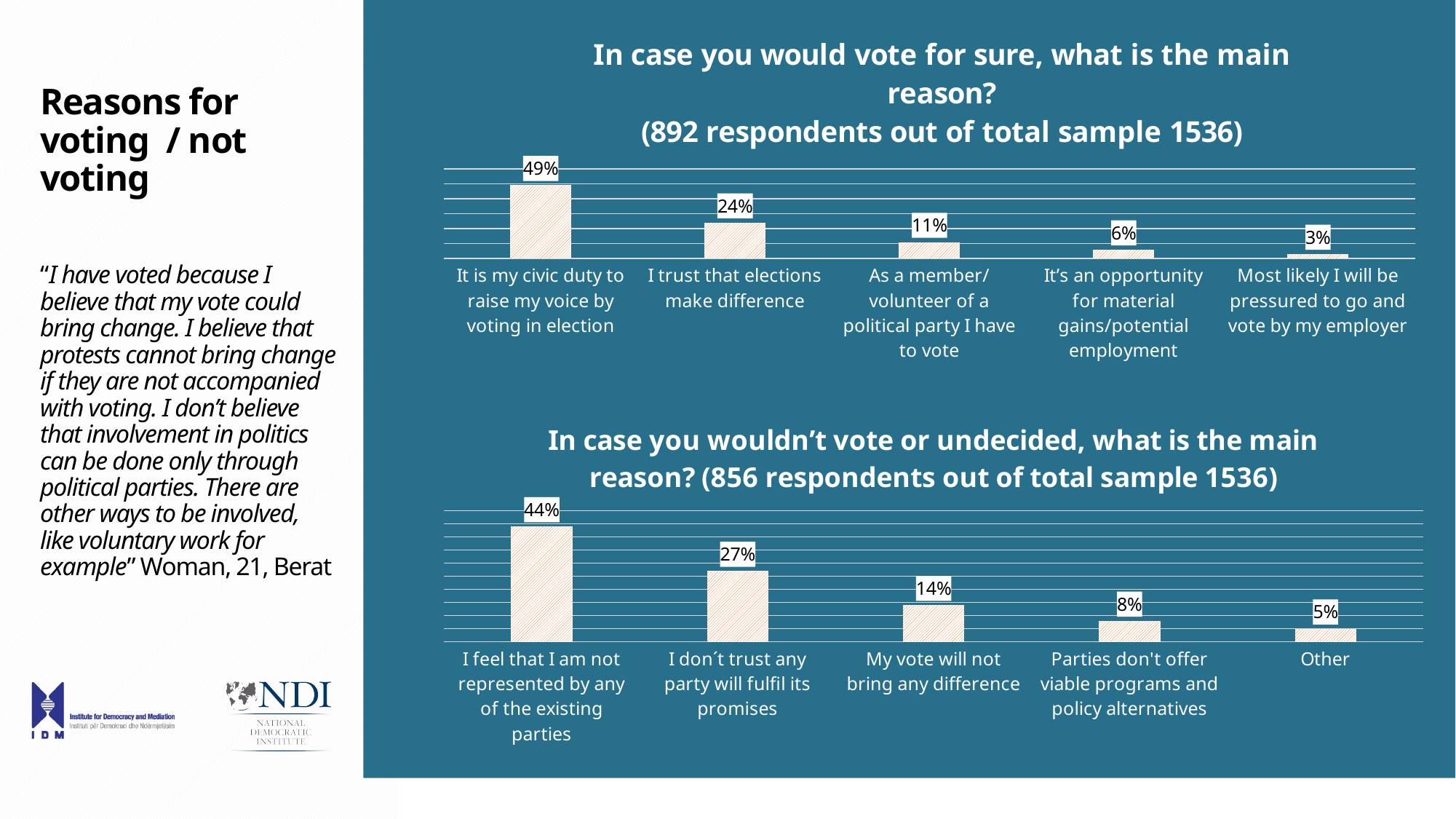
In the bottom chart (In case you wouldn't vote or undecided), what is the value for 'Other'? 5% In the bottom chart (In case you wouldn't vote or undecided), do the values rise or fall from left to right? Fall In the top chart (In case you would vote for sure), what percentage chose 'It is my civic duty to raise my voice by voting in election'? 49% In the bottom chart (In case you wouldn't vote or undecided), what percentage chose 'My vote will not bring any difference'? 14% In the bottom chart (In case you wouldn't vote or undecided), which reason has the highest value? I feel that I am not represented by any of the existing parties In the bottom chart (In case you wouldn't vote or undecided), what is the difference between 'I don't trust any party will fulfil its promises' and 'My vote will not bring any difference'? 13% In the top chart (In case you would vote for sure), what is the value for 'I trust that elections make difference'? 24% What type of chart is the top chart (In case you would vote for sure)? Bar chart In the top chart (In case you would vote for sure), which reason has the lowest value? Most likely I will be pressured to go and vote by my employer In the bottom chart (In case you wouldn't vote or undecided), which is larger: 'Parties don't offer viable programs and policy alternatives' or 'Other'? Parties don't offer viable programs and policy alternatives In the top chart (In case you would vote for sure), how many reason categories are shown? 5 In the top chart (In case you would vote for sure), what is the difference between the civic duty reason and the trust in elections reason? 25%